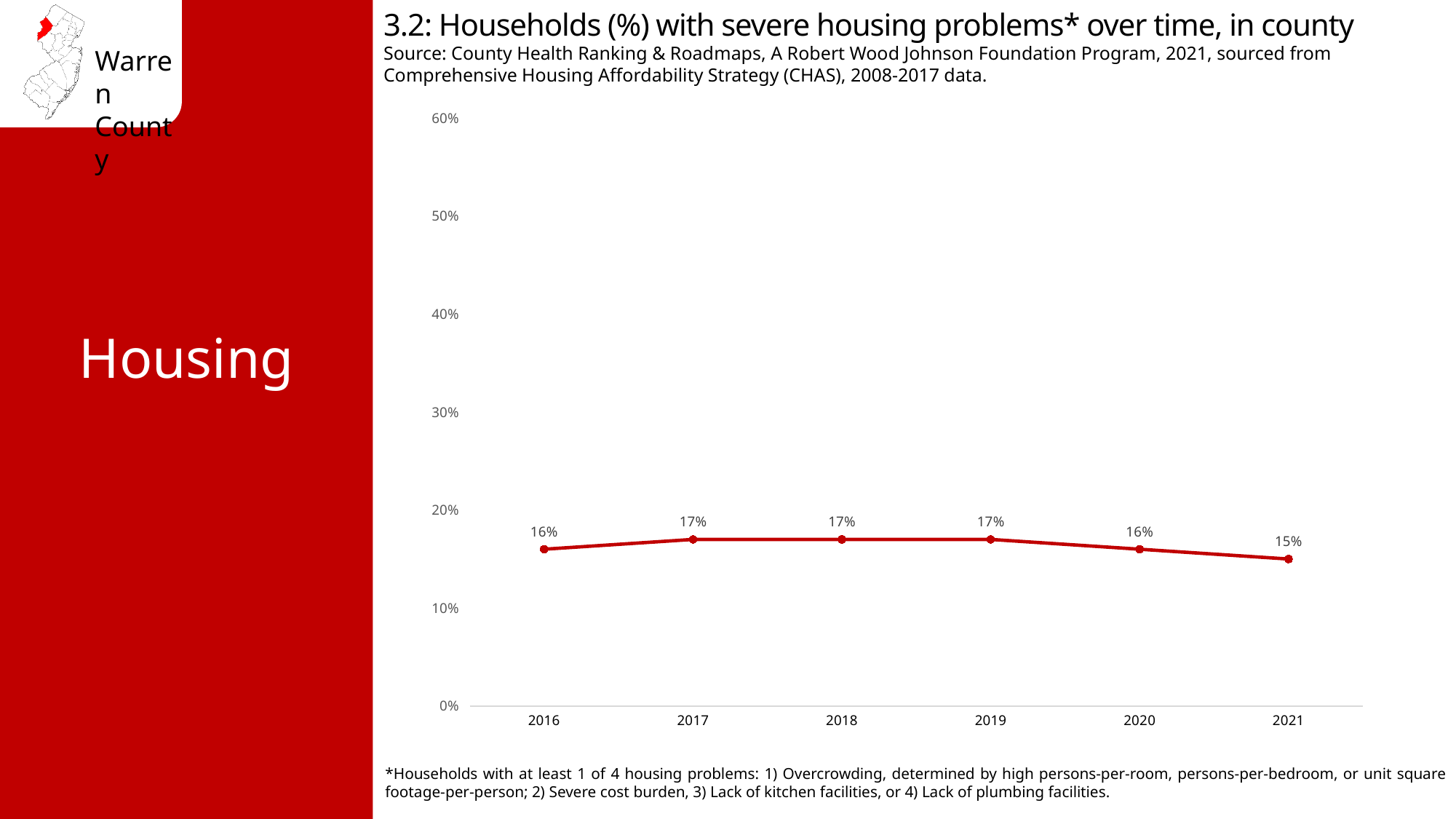
Is the value for 2019 greater or less than 20%? less What is the value shown for 2018? 17% What percentage of households had severe housing problems in 2016? 16% Which year has the lowest percentage of households with severe housing problems? 2021 What is the value shown for 2020? 16% What is the title of the chart? 3.2: Households (%) with severe housing problems* over time, in county Do the values rise or fall from 2019 to 2021? Fall Is the value for 2017 larger than the value for 2021? Yes How many years are plotted on the x axis? 6 What is the difference between the 2019 value and the 2021 value? 2% What kind of chart is shown on the slide? Line chart What is the value shown for 2021? 15%